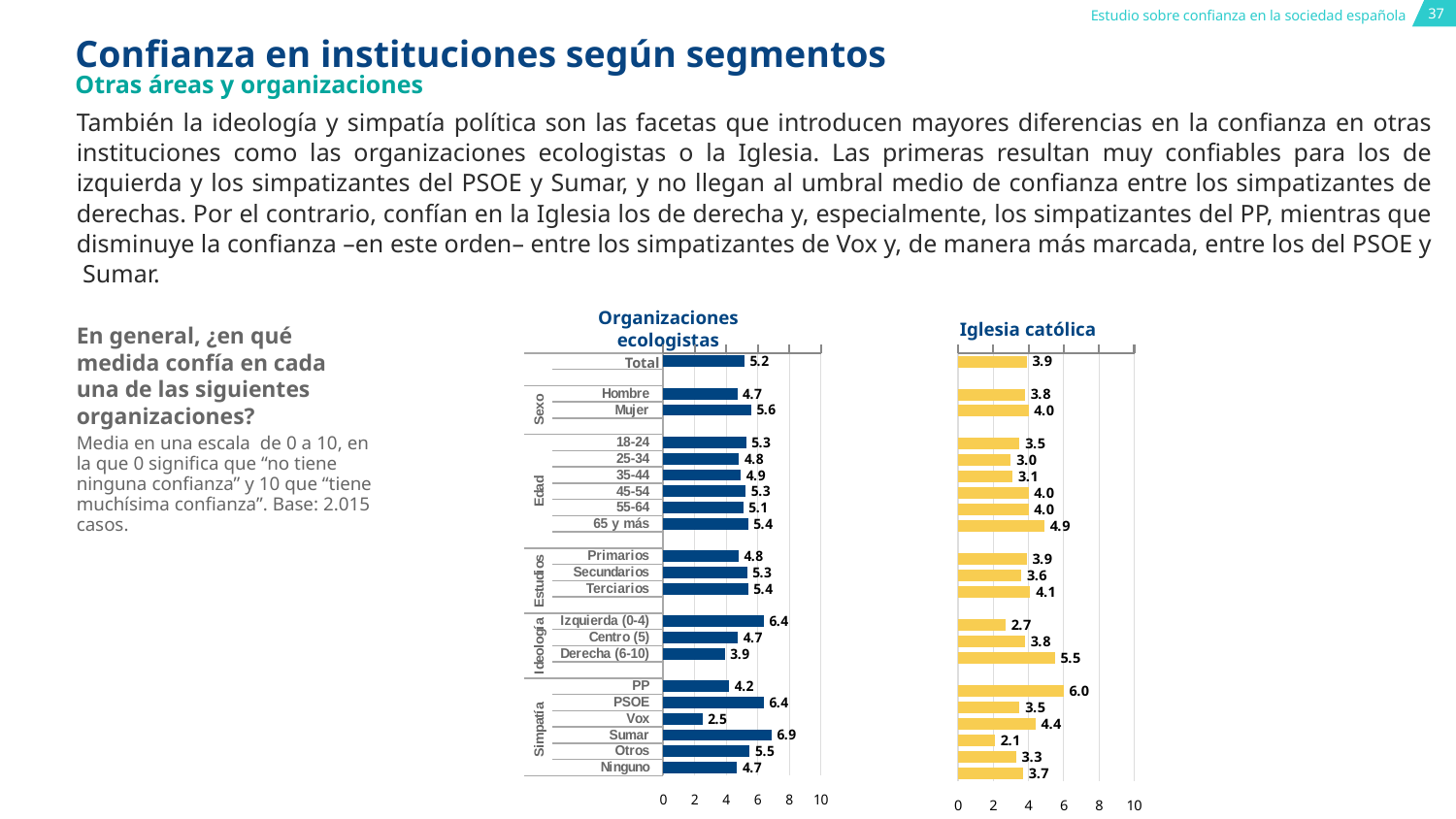
In the 'Iglesia católica' chart, what is the value for PP? 6.0 In the 'Organizaciones ecologistas' chart, which category has the lowest value? Vox In the 'Organizaciones ecologistas' chart, which category has the highest value? Sumar In the 'Iglesia católica' chart, which category has the lowest value? Sumar In the 'Iglesia católica' chart, what is the difference between Derecha (6-10) and Izquierda (0-4)? 2.8 In the 'Iglesia católica' chart, what is the value for Vox? 4.4 In the 'Organizaciones ecologistas' chart, which is larger, the value for Hombre or the value for Mujer? Mujer In the 'Organizaciones ecologistas' chart, what is the value for Total? 5.2 What type of chart is the 'Iglesia católica' chart? Bar chart In the 'Organizaciones ecologistas' chart, what is the difference between Izquierda (0-4) and Derecha (6-10)? 2.5 In the 'Iglesia católica' chart, which category has the highest value? PP In the 'Iglesia católica' chart, is the value for 65 y más greater or less than 4? greater